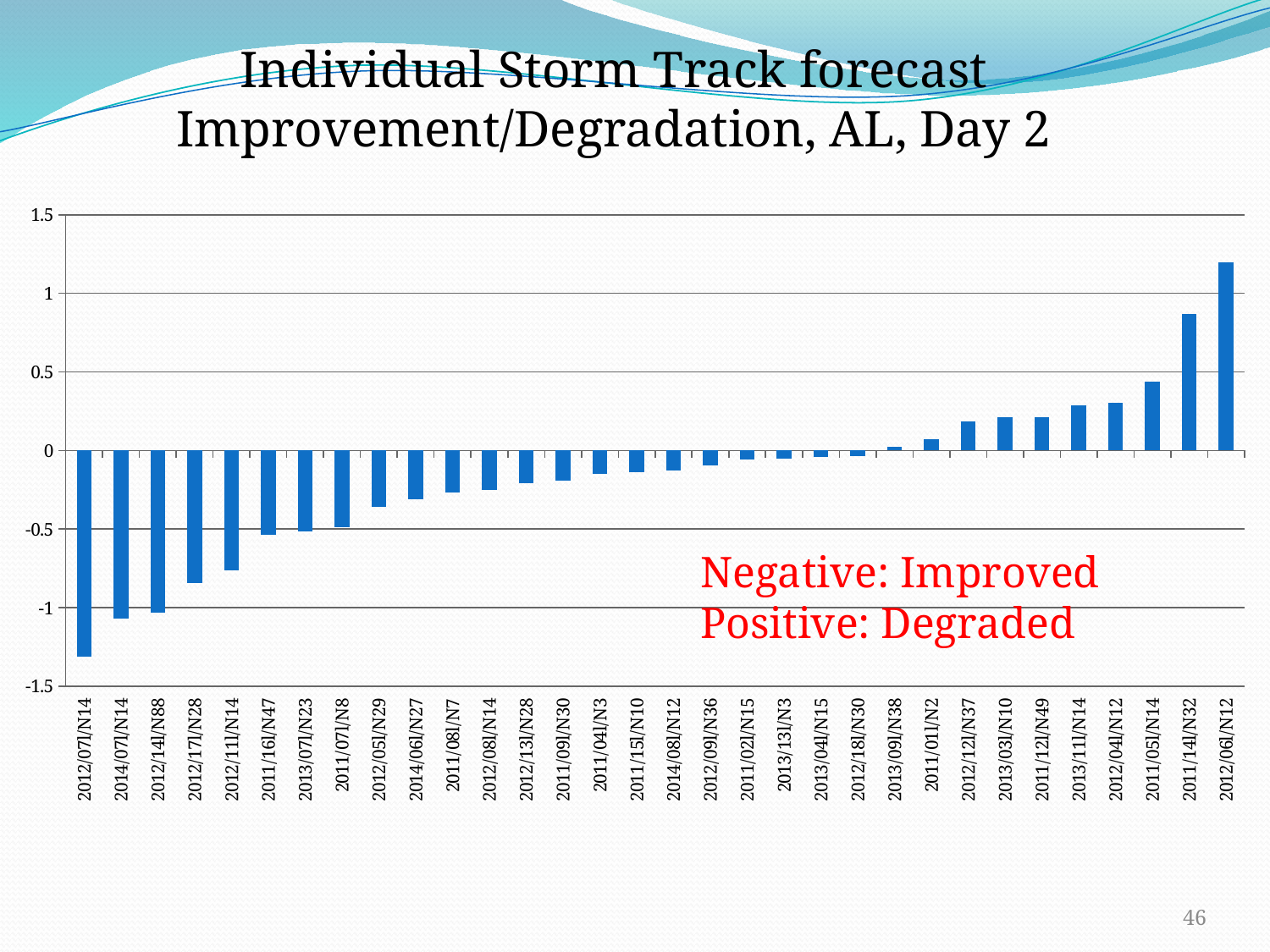
Do the bar values rise or fall moving from left to right along the x axis? rise What kind of chart is shown on the slide? bar chart Is the value for 2012/05/N29 greater or less than -0.5? greater Is the value for 2011/14/N32 greater or less than 0.5? greater Which storm has the lowest (most negative) value in the chart? 2012/07l/N14 Is the value for 2012/06/N12 greater or less than 1? greater According to the red text on the slide, what does a negative value indicate? Improved How many storms (bars) are plotted in the chart? 32 Which storm has the highest (most positive) value in the chart? 2012/06l/N12 Which has the larger value, 2011/14/N32 or 2011/05/N14? 2011/14/N32